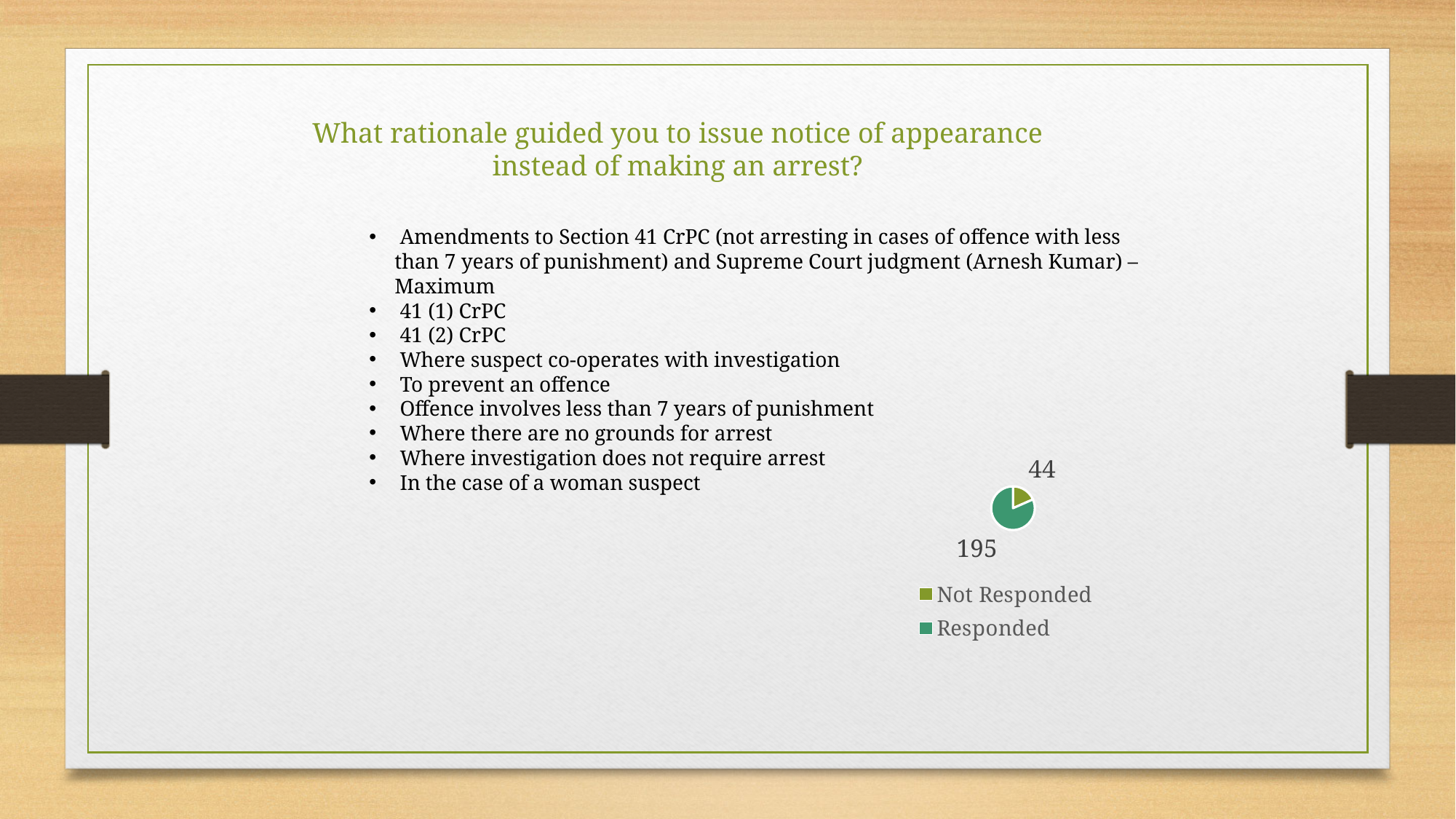
What is the difference between the Responded and Not Responded values in the pie chart? 151 What is the value for Not Responded in the pie chart? 44 What is the value for Responded in the pie chart? 195 What is the total of the two values shown in the pie chart? 239 Which is larger in the pie chart, Responded or Not Responded? Responded How many entries does the pie chart legend list? 2 Which slice of the pie chart is the smallest? Not Responded What kind of chart is shown on the slide? pie chart Which legend entry in the pie chart is shown in the olive-green colour? Not Responded Which legend entry in the pie chart is shown in the darker teal-green colour? Responded How many slices does the pie chart have? 2 Which slice of the pie chart is the largest? Responded